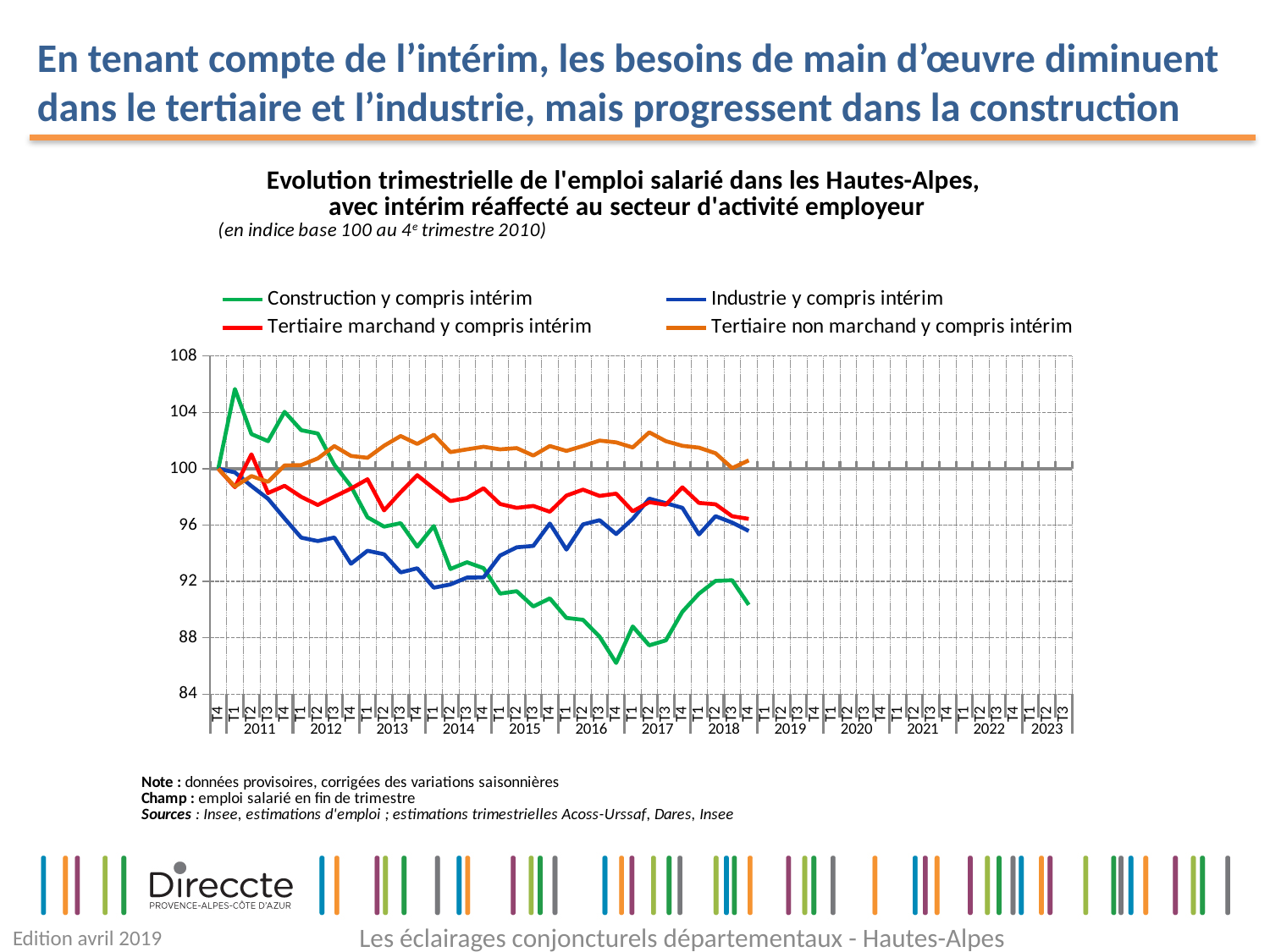
Is the value for Industrie y compris intérim at T1 2014 greater or less than 92? less What is the base of the index used in the chart, according to the subtitle? indice base 100 au 4e trimestre 2010 Does the Industrie y compris intérim series rise or fall overall between T4 2010 and T4 2018? fall How many series does the legend list? 4 Which series falls to the lowest value anywhere on the chart? Construction y compris intérim Which series is drawn in green? Construction y compris intérim Which series reaches the highest value anywhere on the chart? Construction y compris intérim What kind of chart is shown on the slide? line chart At T4 2018, which series is higher: Tertiaire non marchand y compris intérim or Construction y compris intérim? Tertiaire non marchand y compris intérim Is the value for Construction y compris intérim at T1 2011 greater or less than 104? greater Is the value for Tertiaire marchand y compris intérim at T4 2018 greater or less than 100? less